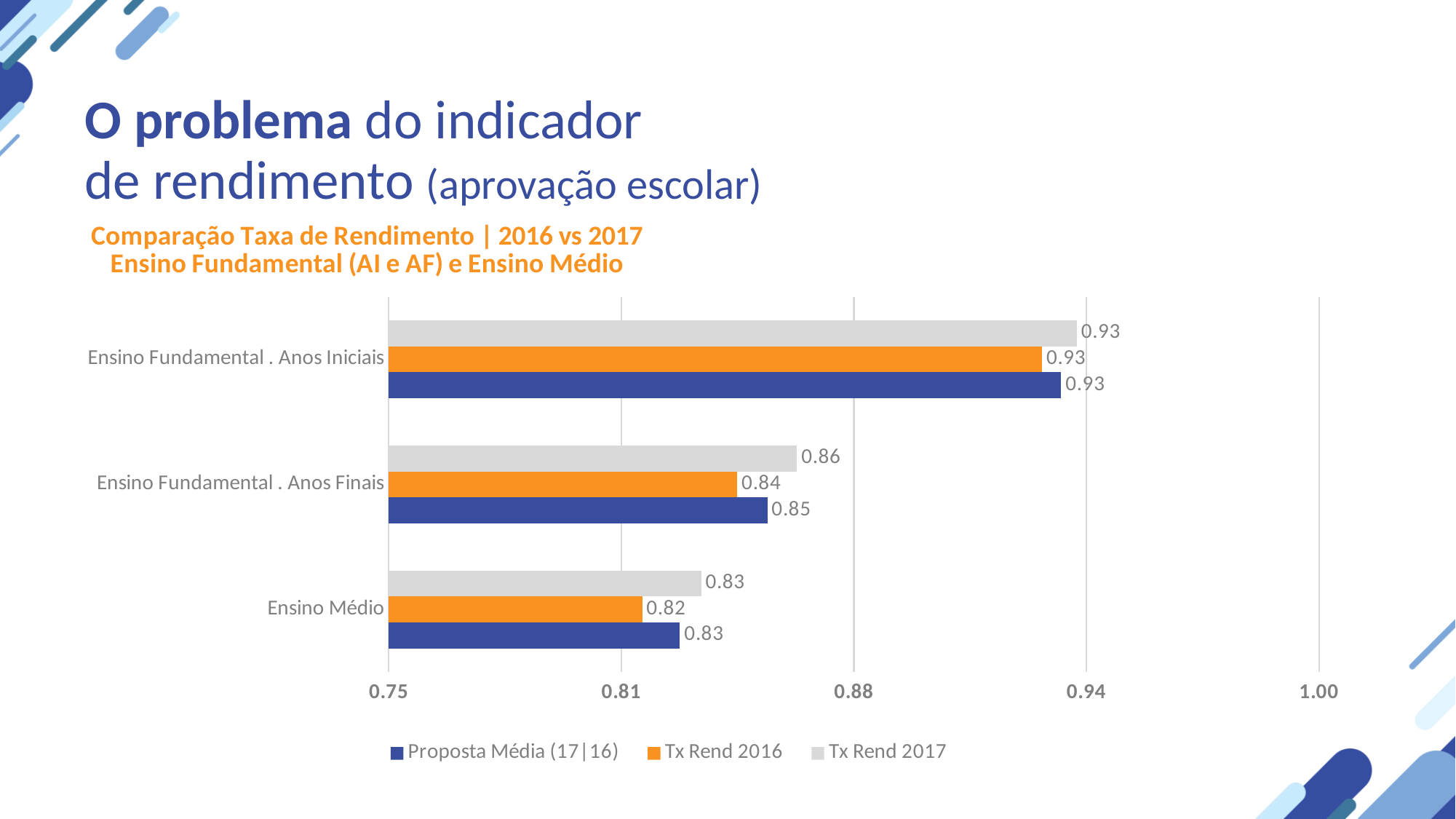
What is the Tx Rend 2016 value for Ensino Fundamental . Anos Finais? 0.84 What is the difference between the Tx Rend 2017 and Tx Rend 2016 values for Ensino Fundamental . Anos Finais? 0.02 Which series is shown in orange in the legend? Tx Rend 2016 What is the Tx Rend 2016 value for Ensino Médio? 0.82 What is the Proposta Média (17|16) value for Ensino Fundamental . Anos Iniciais? 0.93 Which category has the highest Tx Rend 2017 value? Ensino Fundamental . Anos Iniciais Is the Tx Rend 2016 value for Ensino Fundamental . Anos Iniciais greater or less than 0.88? greater How many categories are shown on the chart? 3 What kind of chart is shown on the slide? Bar chart How many series does the legend list? 3 Which category has the lowest Tx Rend 2016 value? Ensino Médio What is the Tx Rend 2017 value for Ensino Médio? 0.83